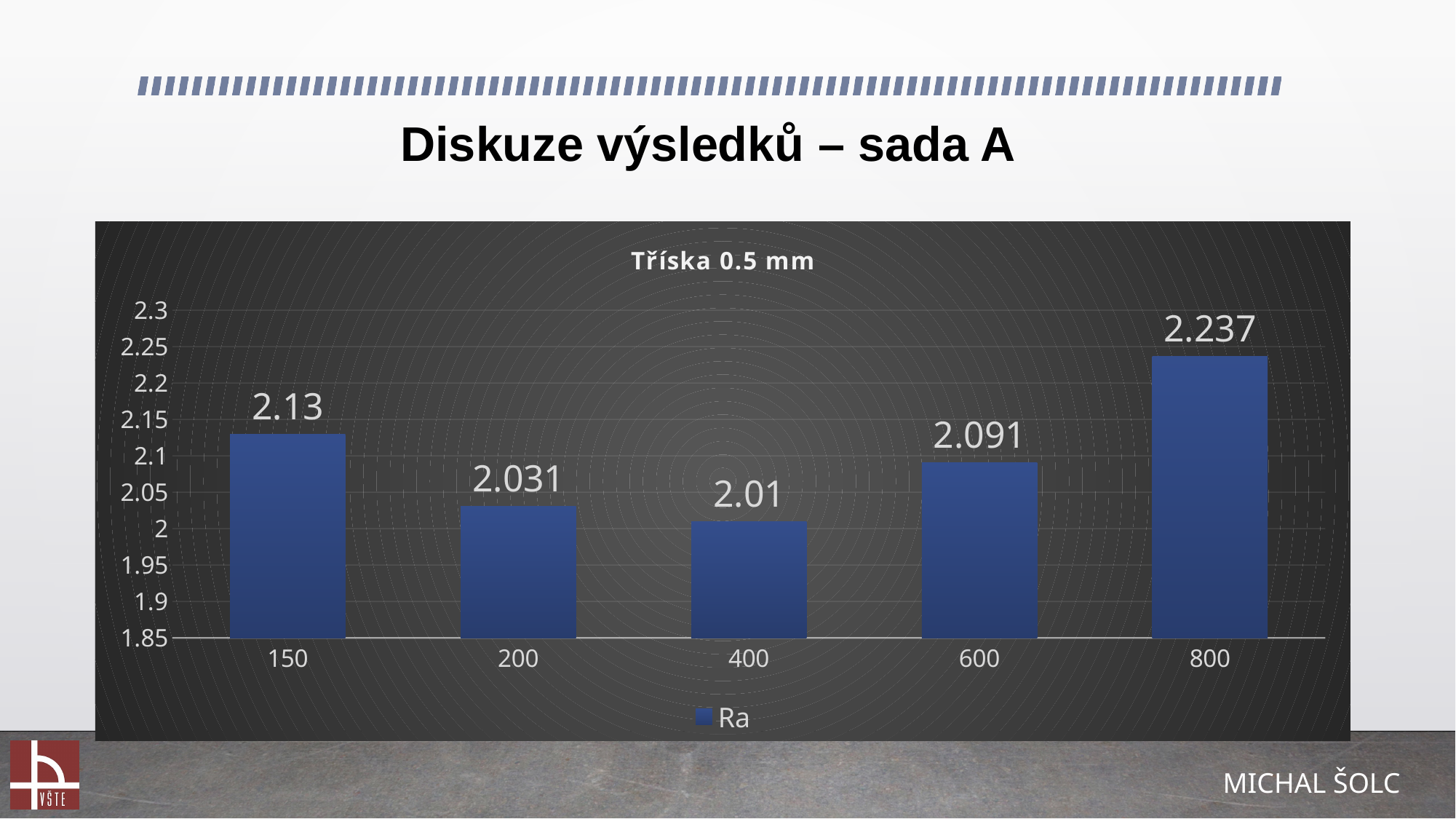
Is the Ra value for 600 greater or less than 2.05? greater Which category has the lowest Ra value? 400 What type of chart is shown on the slide? bar chart Which has a larger Ra value, 200 or 600? 600 How many categories are shown on the x axis? 5 What is the Ra value for category 800? 2.237 Which category has the highest Ra value? 800 What is the Ra value for category 400? 2.01 What is the difference between the Ra values for 150 and 200? 0.099 What is the difference between the Ra values for 800 and 400? 0.227 What is the title of the chart? Tříska 0.5 mm What is the Ra value for category 150? 2.13